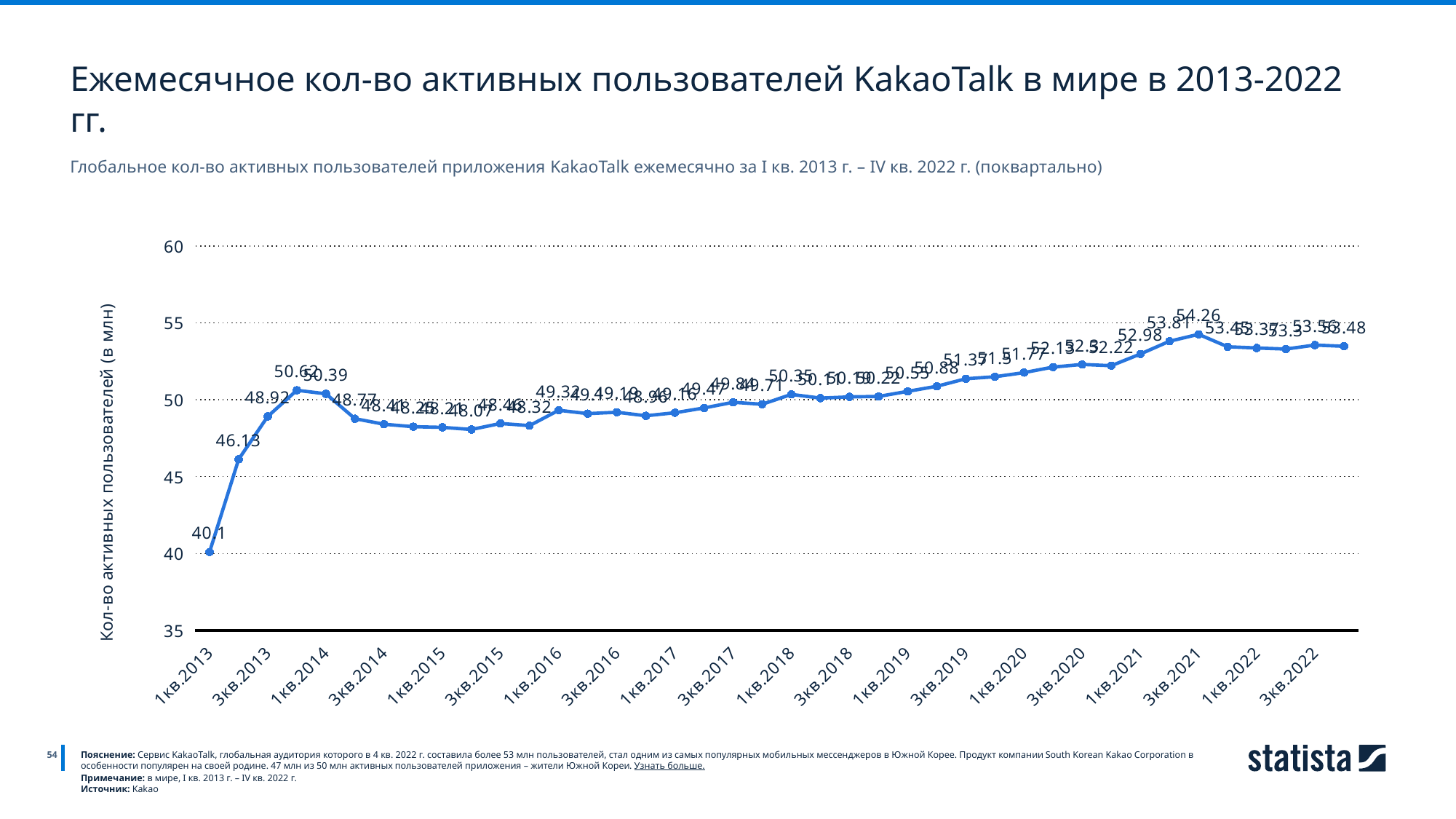
Which quarter has the lowest value? 1кв.2013 What kind of chart is shown on the slide? line chart What is the value for 2кв.2013? 46.13 Is the value for 1кв.2015 greater or less than 50? less What is the value for 1кв.2021? 52.98 Which quarter has the highest value? 3кв.2021 What is the value for 4кв.2013? 50.62 Which is larger, the value for 4кв.2013 or the value for 2кв.2014? 4кв.2013 What is the value for 4кв.2022? 53.48 What is the label of the vertical axis? Кол-во активных пользователей (в млн) What is the value for 1кв.2013? 40.1 What is the difference between the values for 2кв.2013 and 1кв.2013? 6.03